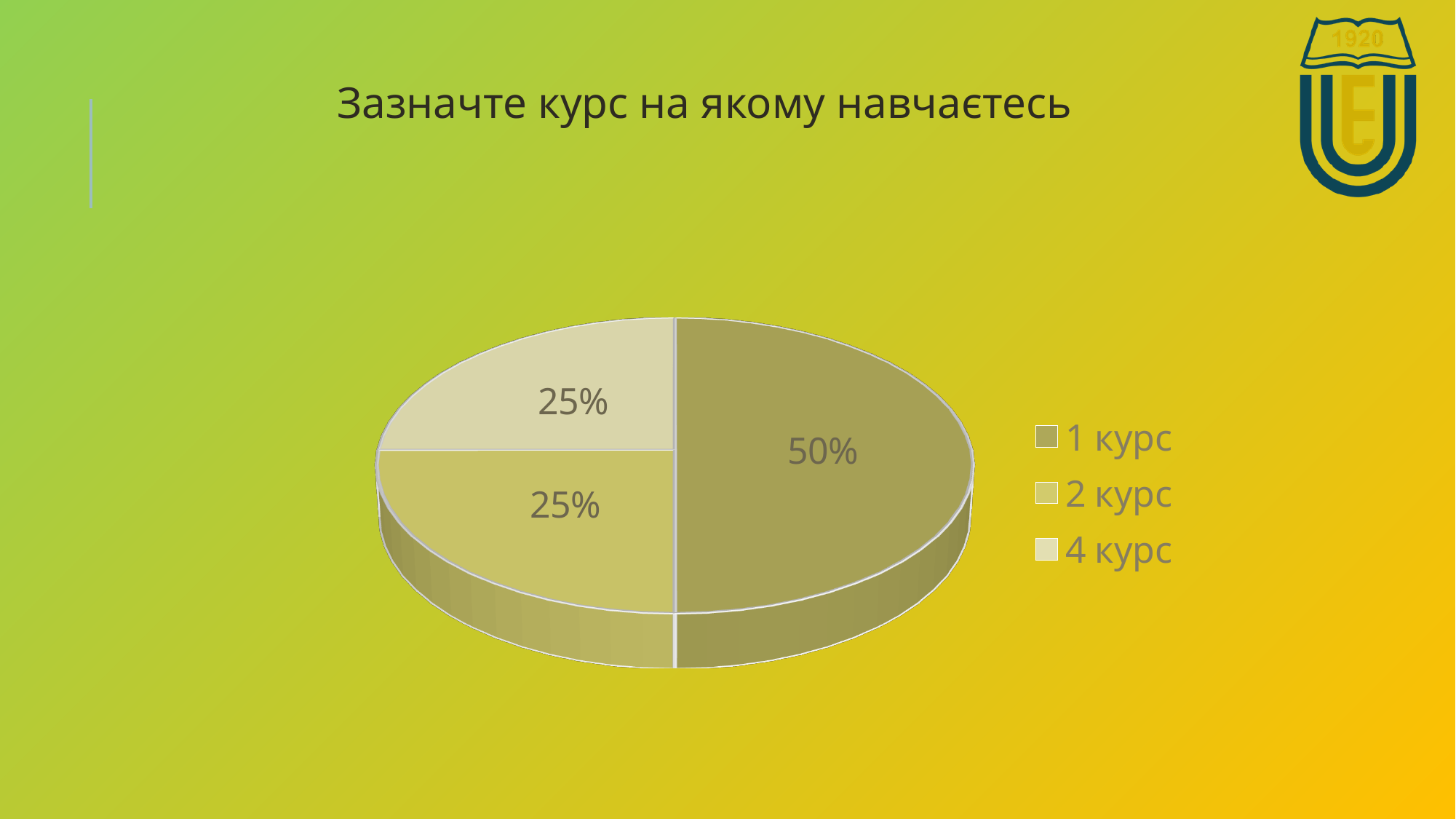
Which category has the largest slice of the pie? 1 курс How many slices does the pie chart have? 3 Do the slices for 2 курс and 4 курс together make up half of the pie? Yes Which is larger, the slice for 1 курс or the slice for 2 курс? 1 курс What share of the pie does 1 курс have? 50% What share of the pie does 4 курс have? 25% What share of the pie does 2 курс have? 25% Which legend entry is shown with the lightest colour? 4 курс What is the title of the slide? Зазначте курс на якому навчаєтесь What is the difference in percentage points between the 1 курс slice and the 4 курс slice? 25 percentage points What kind of chart is shown on the slide? Pie chart How many entries does the legend list? 3